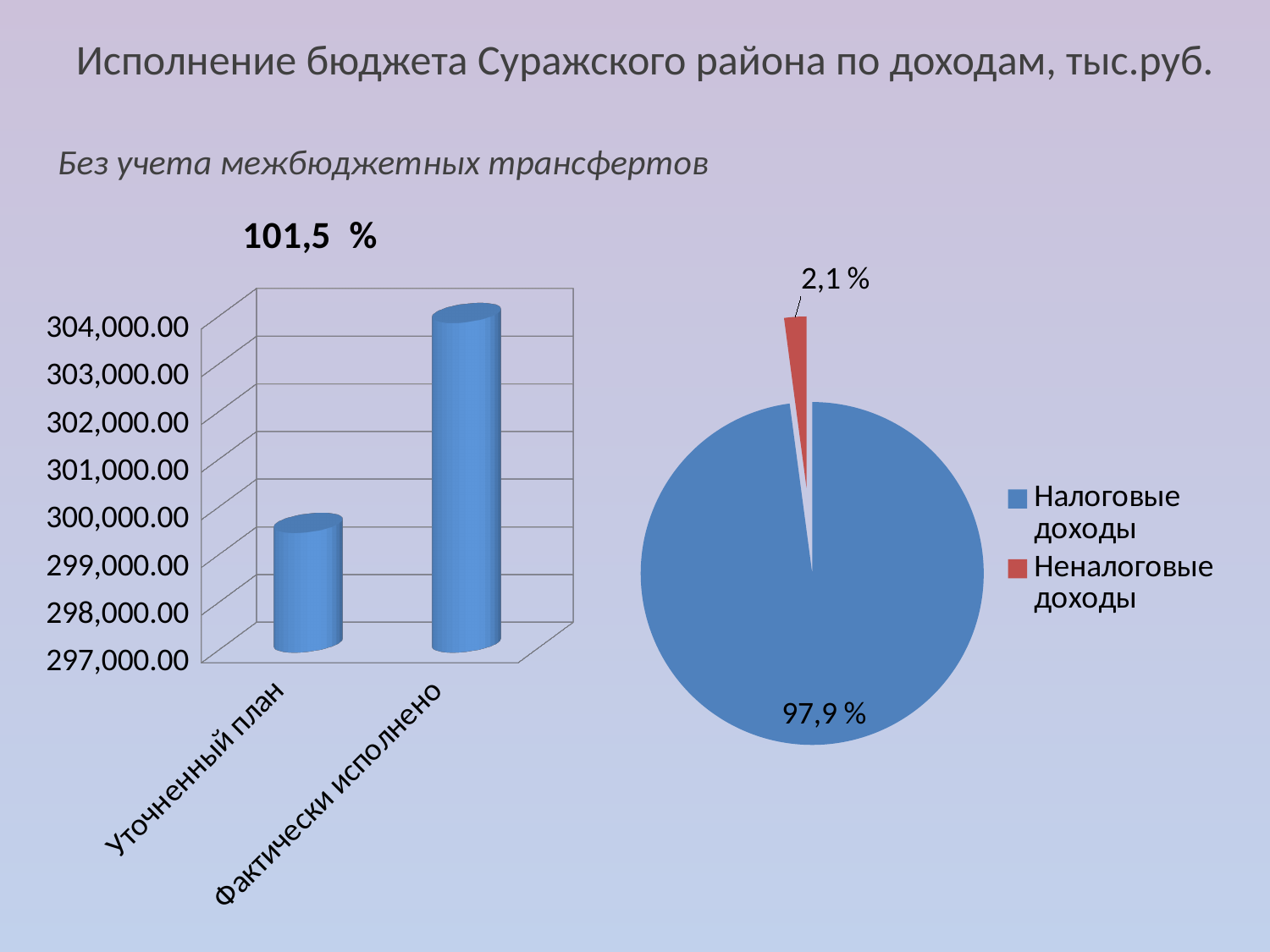
What kind of chart is the chart on the left of the slide? bar chart In the bar chart on the left, how many categories are shown? 2 In the bar chart on the left, is the value for Уточненный план greater or less than 301,000.00? less In the pie chart on the right, what share does Налоговые доходы have? 97,9 % What percentage figure is printed above the bar chart on the left? 101,5 % In the bar chart on the left, is the value for Уточненный план greater or less than 298,000.00? greater What kind of chart is the chart on the right of the slide? pie chart In the pie chart on the right, what share does Неналоговые доходы have? 2,1 % In the bar chart on the left, which category has the higher value? Фактически исполнено In the bar chart on the left, is the value for Фактически исполнено greater or less than 303,000.00? greater In the pie chart on the right, how many entries does the legend list? 2 In the bar chart on the left, which category has the lower value? Уточненный план